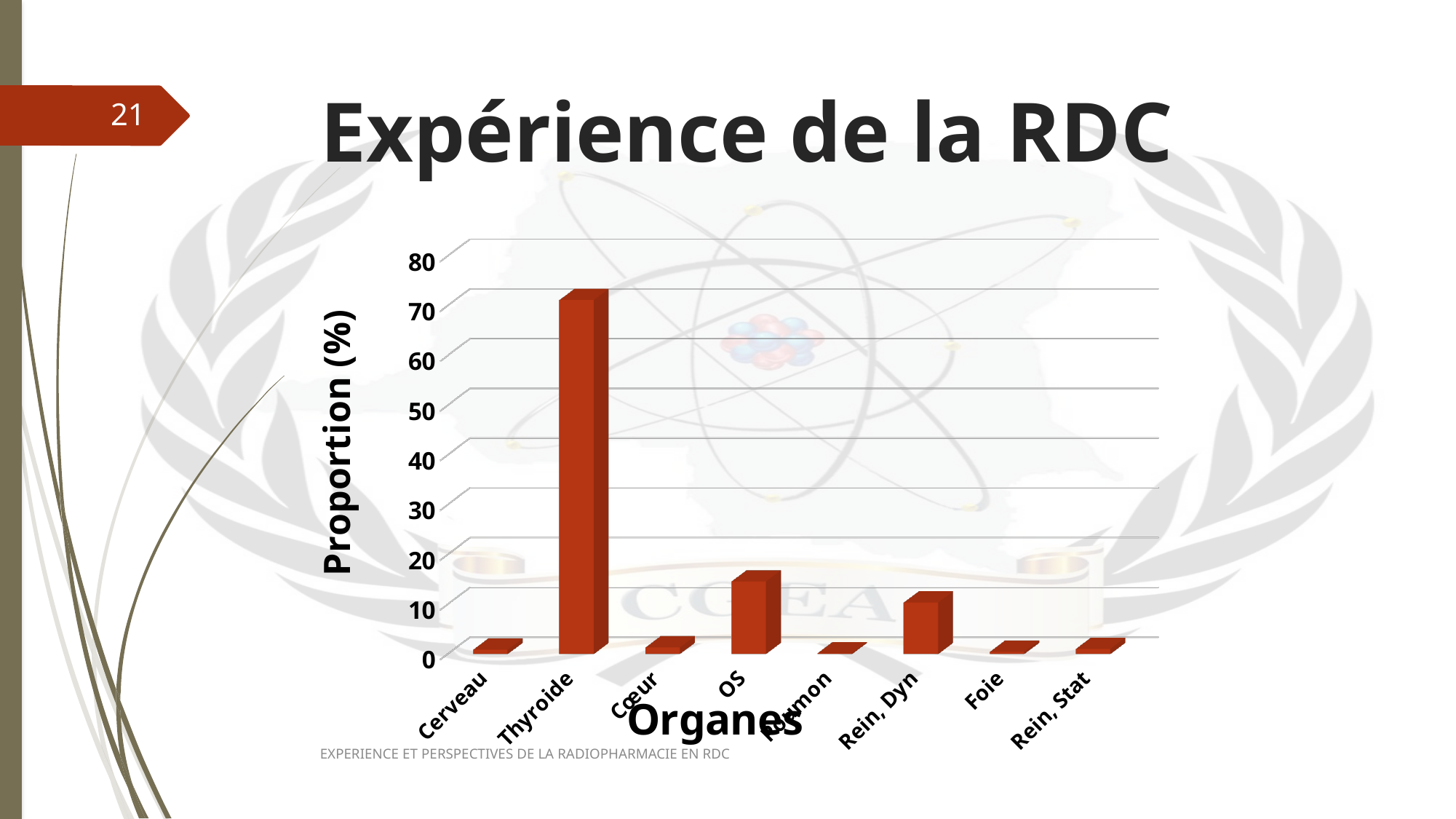
What is the label of the vertical axis? Proportion (%) Is the value for Cerveau greater or less than 10? less Is the value for OS greater or less than 10? greater How many organ categories are plotted on the x axis? 8 Is the value for Thyroide greater or less than 60? greater Which organ has the highest proportion in the chart? Thyroide What kind of chart is shown on the slide? bar chart Which is larger, the value for Thyroide or the value for OS? Thyroide What is the label of the horizontal axis? Organes Which is larger, the value for OS or the value for Rein, Dyn? OS